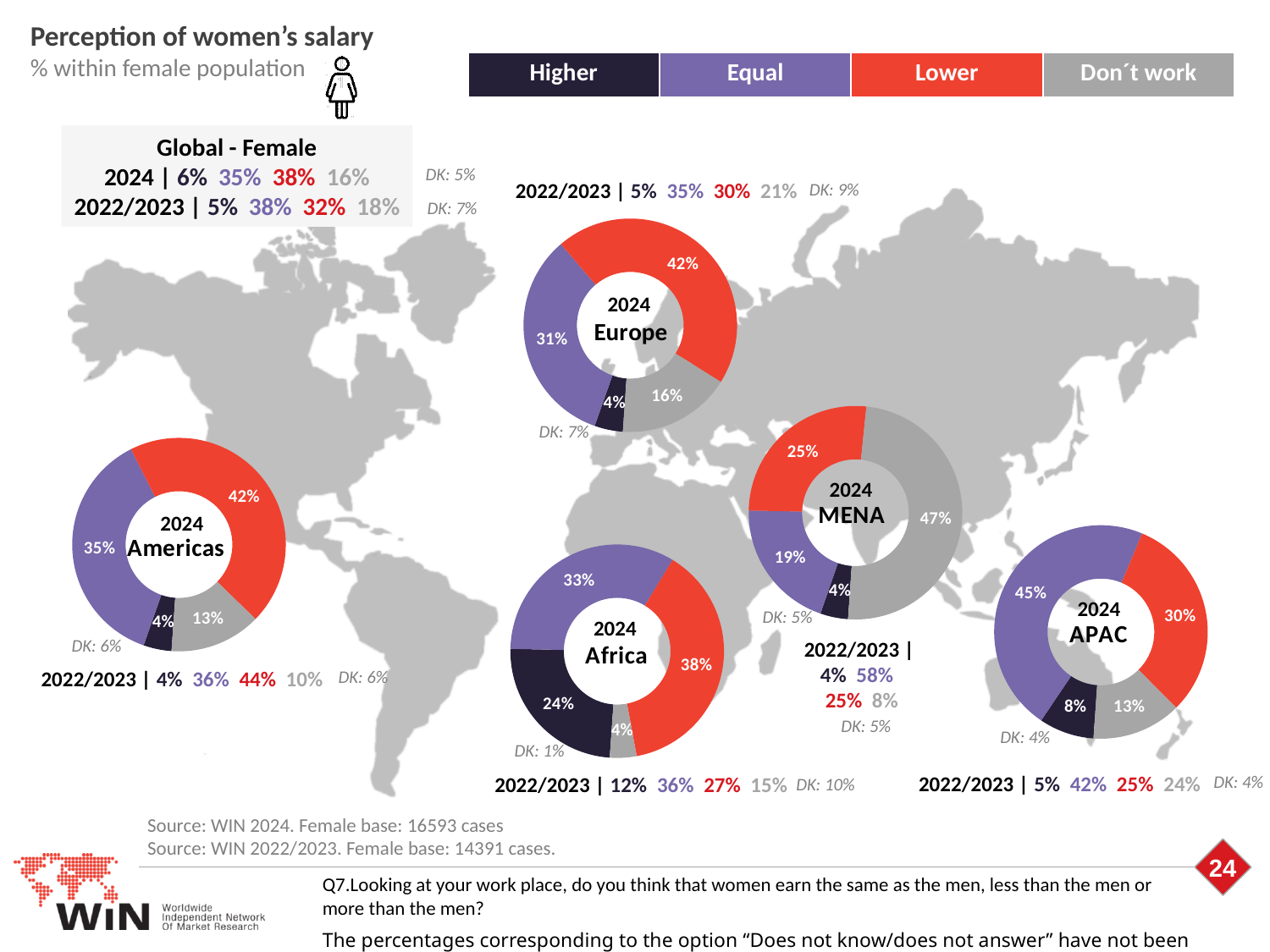
In the 2024 APAC donut chart, which category has the largest share? Equal How many series does the legend at the top of the slide list? 4 In the 2024 Americas donut chart, what percentage corresponds to the 'Equal' category? 35% In the 2024 MENA donut chart, which category has the smallest share? Higher In the 2024 Africa donut chart, which is larger: the 'Lower' share or the 'Equal' share? Lower In the 2024 Europe donut chart, what percentage of women say their salary is lower than men's? 42% In the 2024 MENA donut chart, what percentage corresponds to 'Don't work'? 47% What type of chart is used to show the 2024 regional results on the slide? Donut (pie) chart In the 2024 Europe donut chart, what is the difference between the 'Lower' and 'Equal' percentages? 11% In the 2024 Africa donut chart, what percentage of women say their salary is higher than men's? 24% Which colour represents the 'Lower' category in the legend? Red In the 2024 APAC donut chart, what is the difference between the 'Equal' and 'Lower' percentages? 15%